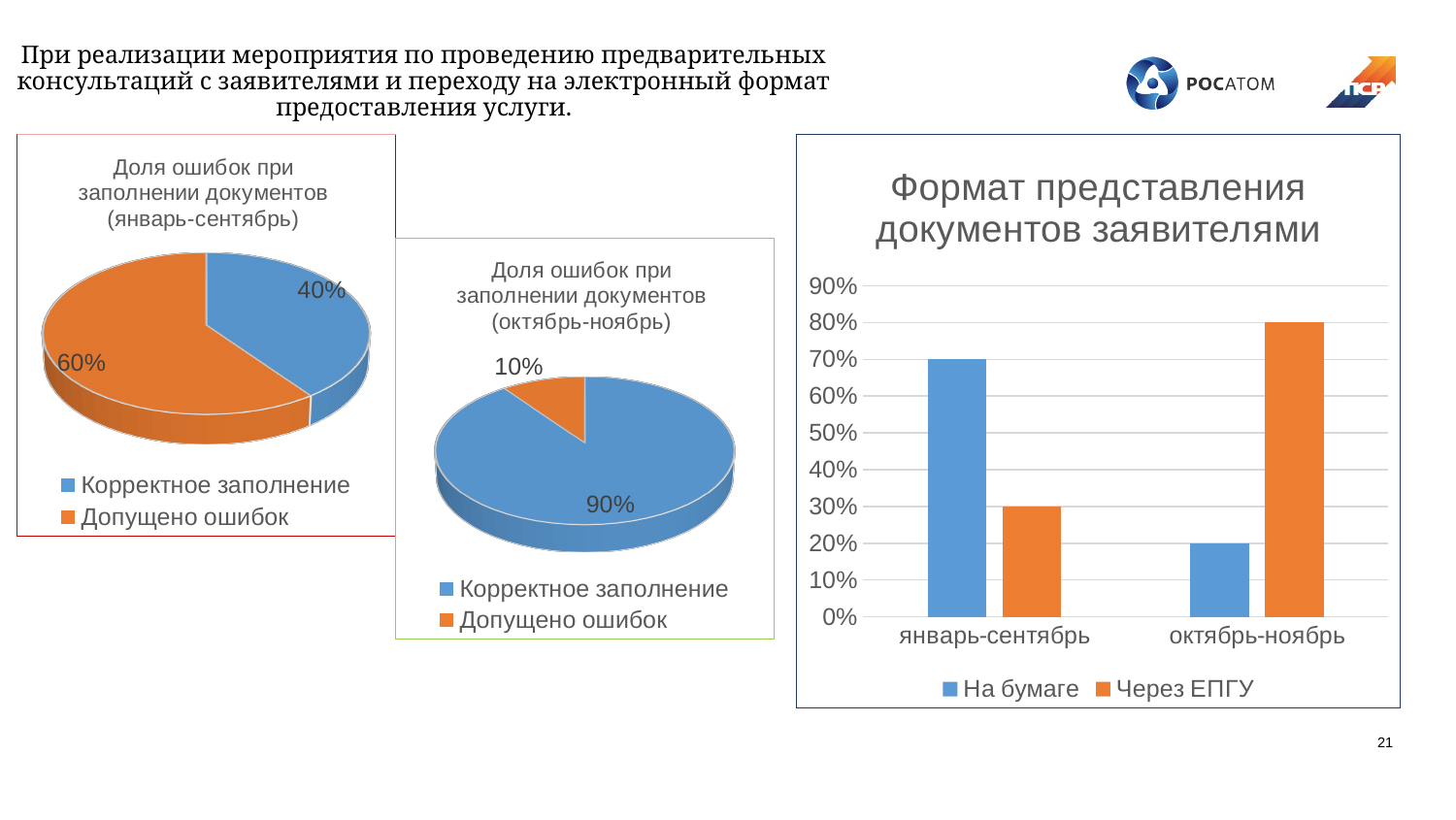
In the bar chart 'Формат представления документов заявителями', what is the difference between 'Через ЕПГУ' in октябрь-ноябрь and 'Через ЕПГУ' in январь-сентябрь? 50% In the bar chart 'Формат представления документов заявителями', how many series does the legend list? 2 What kind of chart is the chart titled 'Формат представления документов заявителями'? bar chart In the bar chart 'Формат представления документов заявителями', which is larger in январь-сентябрь: 'На бумаге' or 'Через ЕПГУ'? На бумаге In the pie chart 'Доля ошибок при заполнении документов (январь-сентябрь)', what share is labelled for 'Допущено ошибок'? 60% In the bar chart 'Формат представления документов заявителями', does the value for 'На бумаге' rise or fall from январь-сентябрь to октябрь-ноябрь? fall In the pie chart 'Доля ошибок при заполнении документов (октябрь-ноябрь)', which slice is smaller? Допущено ошибок In the pie chart 'Доля ошибок при заполнении документов (январь-сентябрь)', what share is labelled for 'Корректное заполнение'? 40% In the bar chart 'Формат представления документов заявителями', what is the value for 'На бумаге' in октябрь-ноябрь? 20% In the bar chart 'Формат представления документов заявителями', what is the value for 'Через ЕПГУ' in октябрь-ноябрь? 80% In the bar chart 'Формат представления документов заявителями', what is the value for 'На бумаге' in январь-сентябрь? 70% In the pie chart 'Доля ошибок при заполнении документов (октябрь-ноябрь)', what share is labelled for 'Корректное заполнение'? 90%